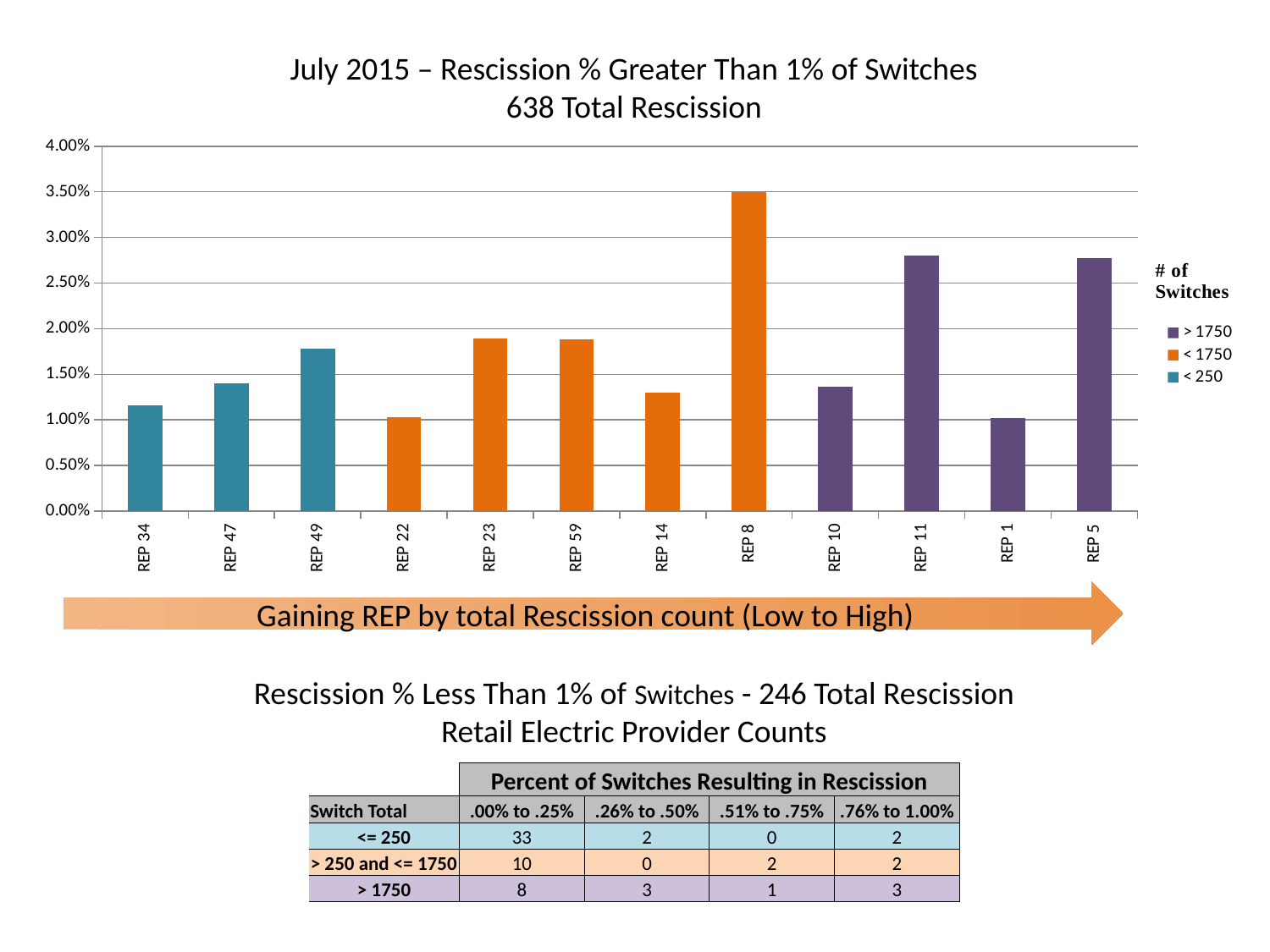
How many entries does the chart legend list? 3 Which REP has the highest rescission percentage on the chart? REP 8 Is the value for REP 34 greater or less than 1.50%? less Is the value for REP 14 greater or less than 1.50%? less Which has a higher rescission percentage, REP 8 or REP 11? REP 8 Which has a higher rescission percentage, REP 49 or REP 47? REP 49 Is the value for REP 49 greater or less than 1.50%? greater What kind of chart is shown on the slide? bar chart How many REPs are plotted on the chart? 12 According to the legend, which switch-count group does the orange bar colour represent? < 1750